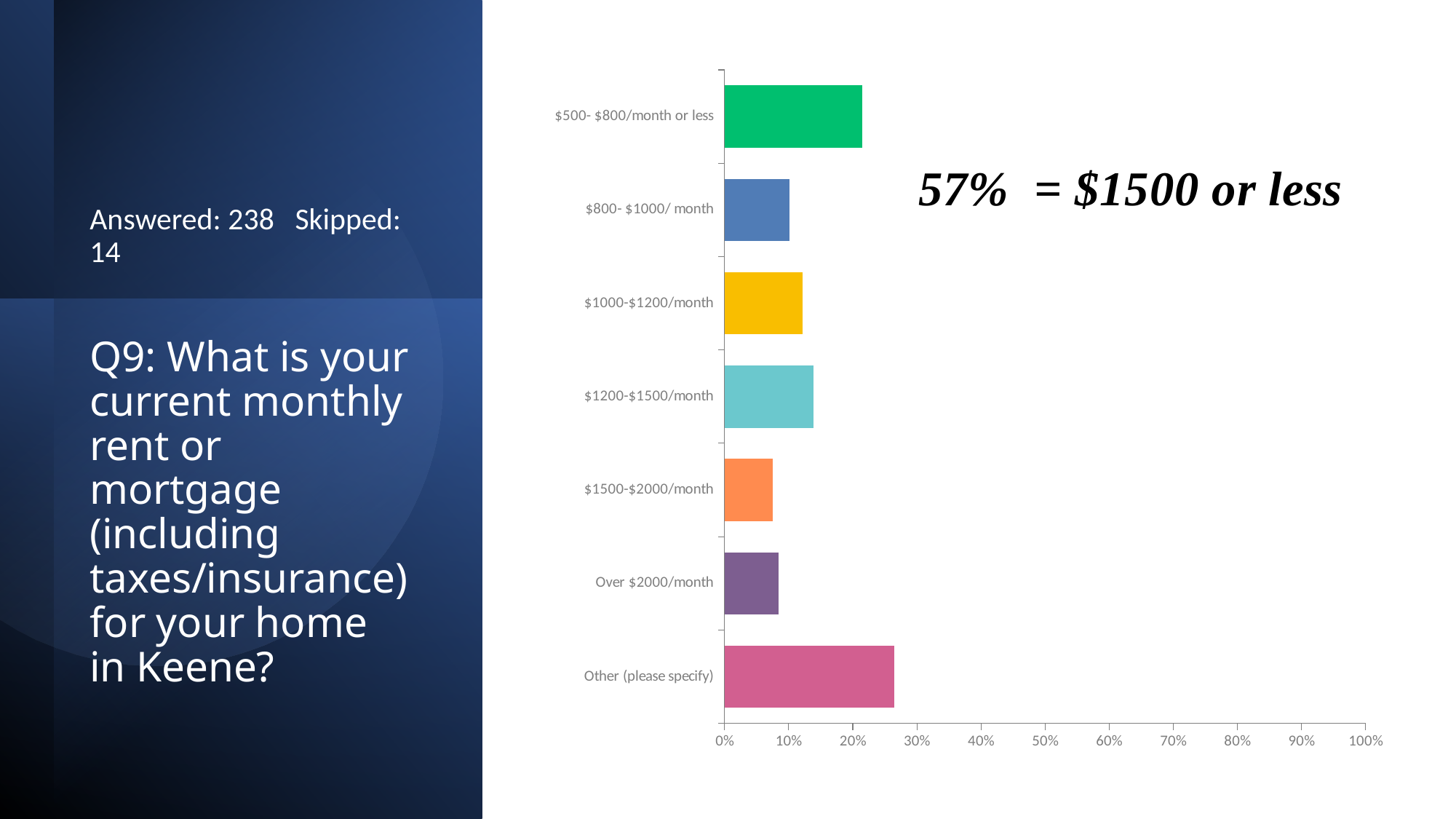
Which is larger, the value for "Other (please specify)" or the value for "$500- $800/month or less"? Other (please specify) How many categories are plotted in the chart? 7 Is the value for "$1500-$2000/month" greater or less than 10%? less Is the value for "Other (please specify)" greater or less than 20%? greater According to the text next to the chart, what percentage of respondents pay $1500 or less? 57% What is the maximum value shown on the chart's horizontal axis? 100% Which category has the highest value in the chart? Other (please specify) What kind of chart is shown on the slide? bar chart Is the value for "$500- $800/month or less" greater or less than 10%? greater Which is larger, the value for "$1200-$1500/month" or the value for "$1500-$2000/month"? $1200-$1500/month